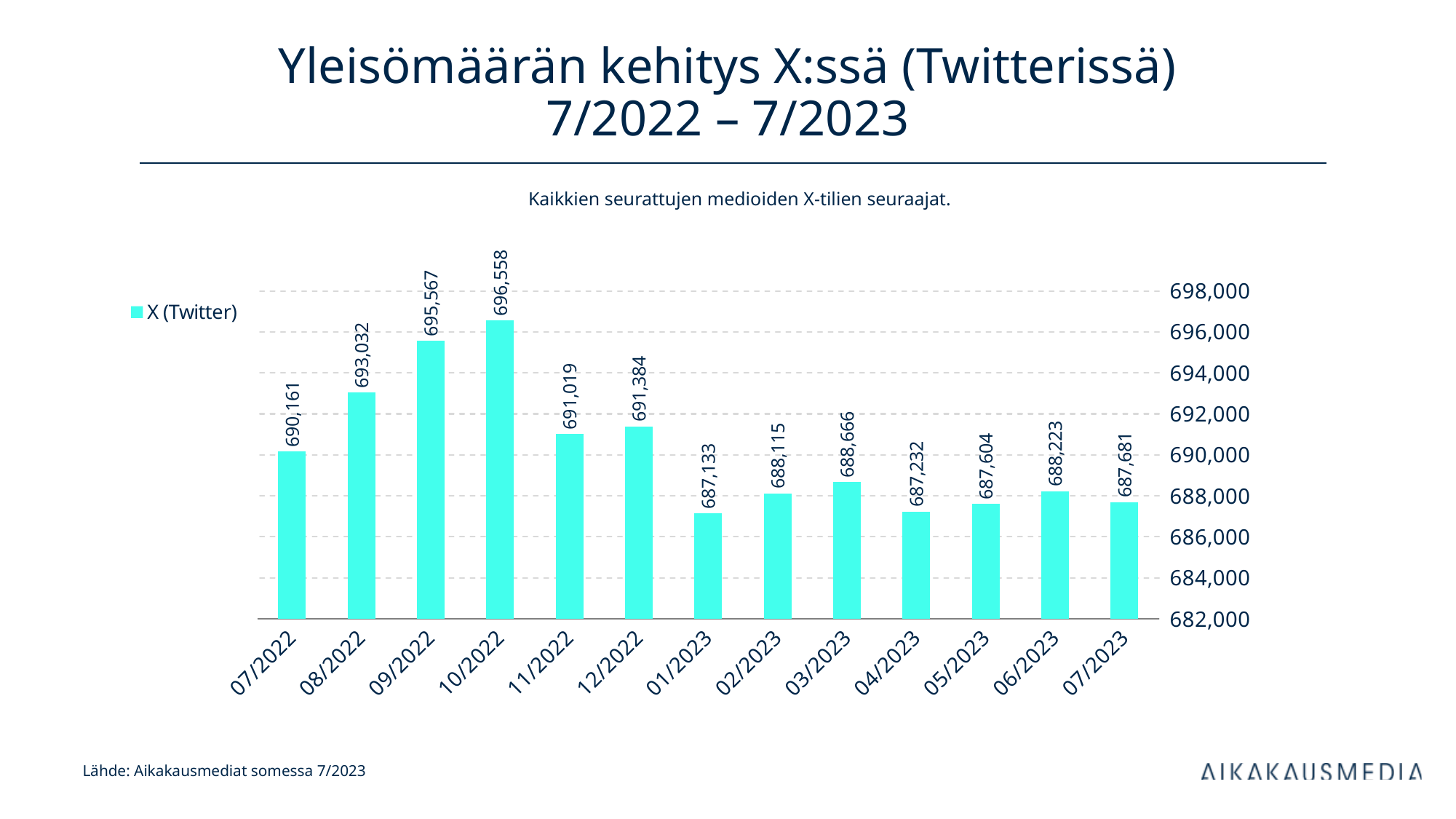
Which is larger, the value for 08/2022 or the value for 12/2022? 08/2022 How many months are shown on the x axis? 13 What is the difference between the values for 10/2022 and 09/2022? 991 What is the value for 01/2023? 687,133 Which month has the highest value? 10/2022 What is the value for 10/2022? 696,558 Is the value for 11/2022 greater or less than 690,000? greater What series does the legend list? X (Twitter) Which month has the lowest value? 01/2023 What is the value for 07/2023? 687,681 What kind of chart is shown on the slide? bar chart What is the difference between the values for 07/2022 and 07/2023? 2,480